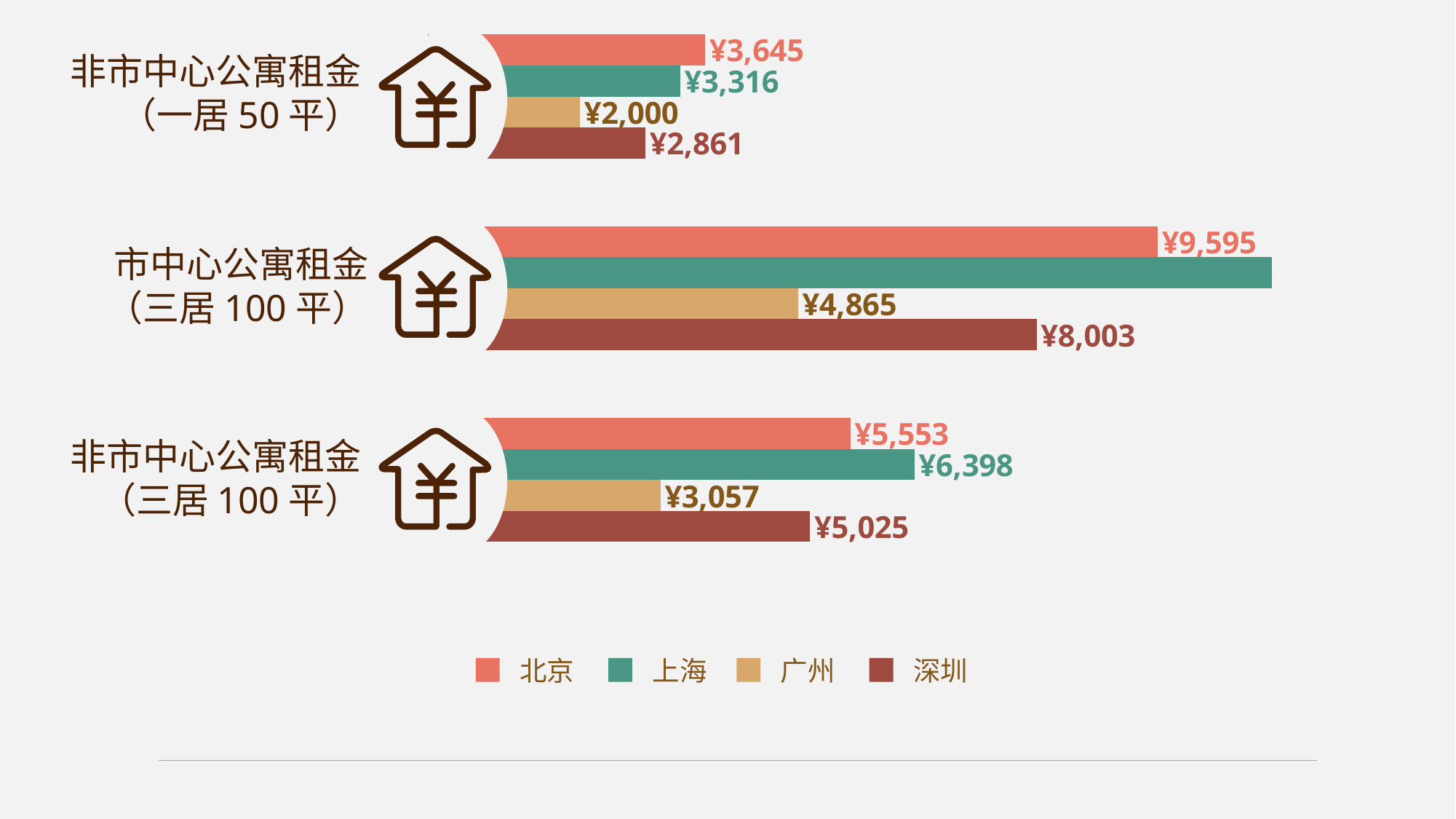
How many categories are shown in the chart? 3 What is the value for 深圳 in the 非市中心公寓租金（三居 100 平） category? ¥5,025 What is the value for 广州 in the 市中心公寓租金（三居 100 平） category? ¥4,865 In the 非市中心公寓租金（一居 50 平） category, which is larger, 上海 or 深圳? 上海 What kind of chart is shown on the slide? Bar chart How many series does the legend list? 4 What is the value for 北京 in the 非市中心公寓租金（一居 50 平） category? ¥3,645 Which city has the highest value in the 市中心公寓租金（三居 100 平） category? 上海 What is the value for 上海 in the 非市中心公寓租金（三居 100 平） category? ¥6,398 What is the difference between 北京 and 深圳 in the 市中心公寓租金（三居 100 平） category? ¥1,592 What is the difference between 上海 and 北京 in the 非市中心公寓租金（三居 100 平） category? ¥845 Which city has the lowest value in the 非市中心公寓租金（一居 50 平） category? 广州